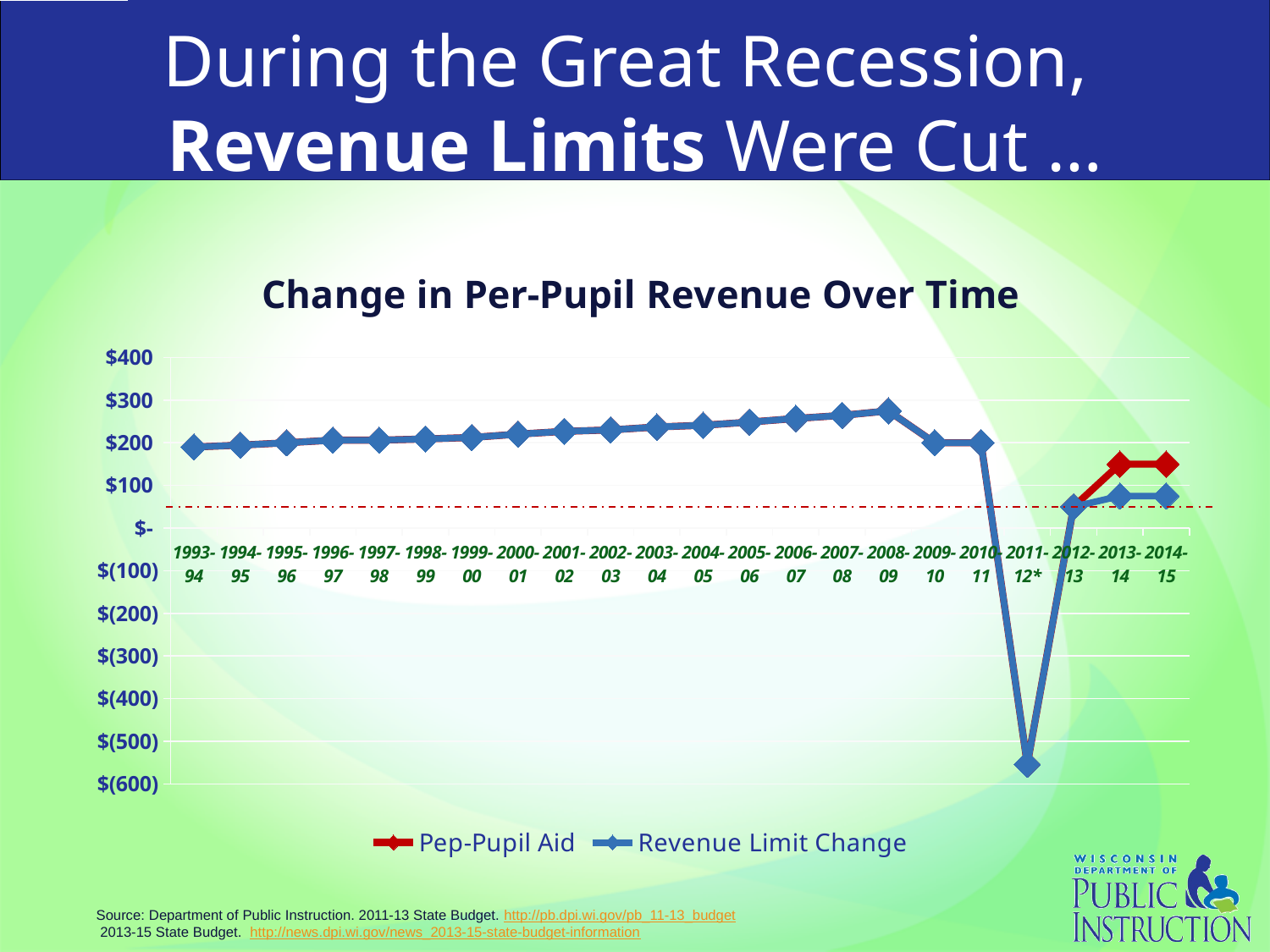
Is the Revenue Limit Change for 2008-09 greater or less than $200? greater In which school year is the Revenue Limit Change lowest? 2011-12* Which series is drawn in red? Pep-Pupil Aid What is the title of the chart? Change in Per-Pupil Revenue Over Time In which school year is the Revenue Limit Change highest? 2008-09 What kind of chart is shown on the slide? line chart In 2014-15, which is larger: Pep-Pupil Aid or Revenue Limit Change? Pep-Pupil Aid Is the Revenue Limit Change for 2011-12* greater or less than $(500)? less How many school years are shown along the x axis? 22 How many series does the legend list? 2 Is the Pep-Pupil Aid value for 2013-14 greater or less than $100? greater Does the Revenue Limit Change rise or fall from 1993-94 to 2008-09? rise